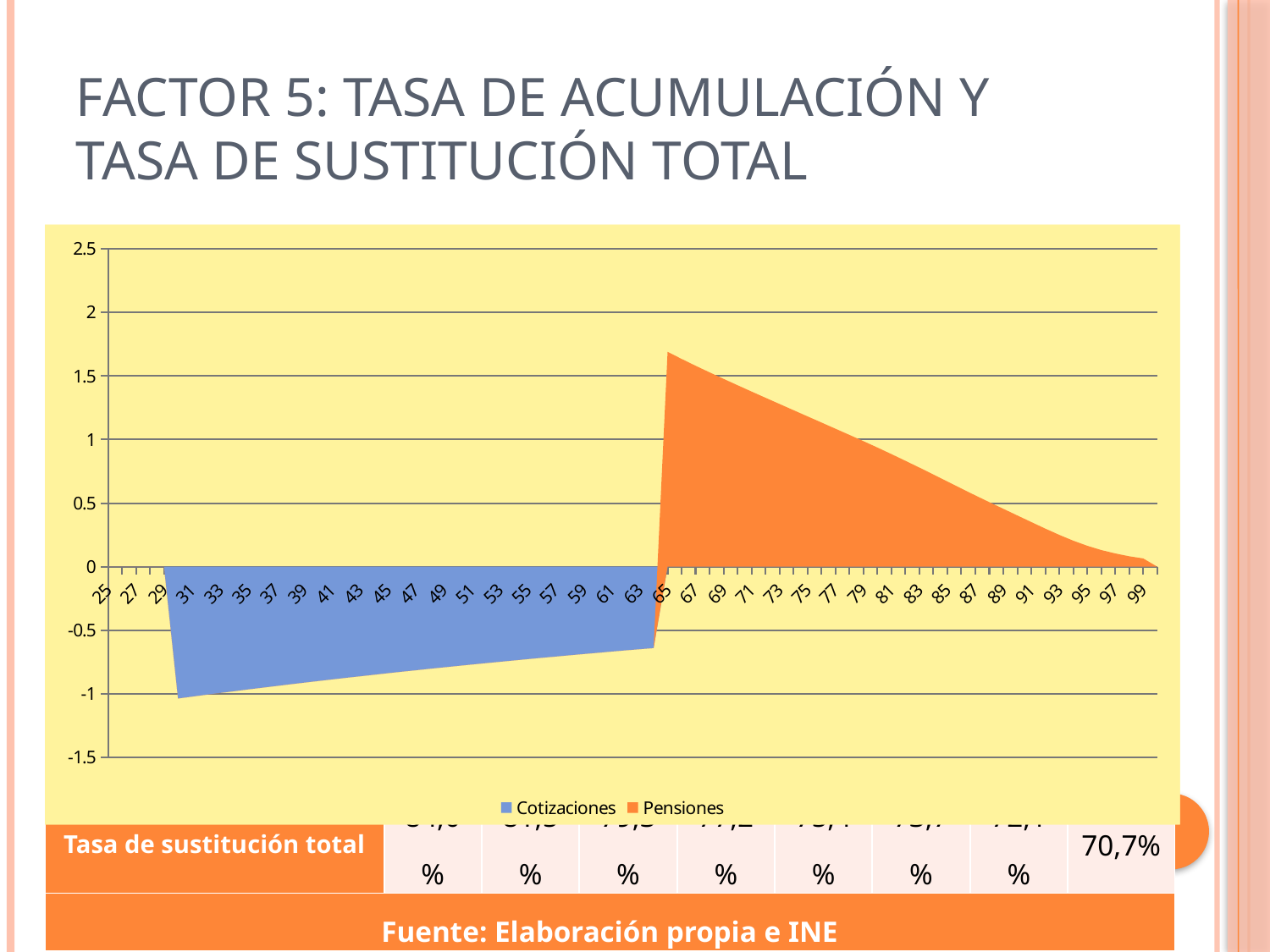
Is the value of Cotizaciones at age 63 greater or less than -1? greater Which series has positive values in the chart, Cotizaciones or Pensiones? Pensiones Is the value of Pensiones at age 65 greater or less than 1.5? greater Do the Cotizaciones values rise or fall as age increases from 31 to 63? Rise Is the value of Pensiones at age 71 greater or less than 1? greater How many series does the chart legend list? 2 Which colour represents the Pensiones series in the chart? Orange What are the two series named in the chart legend? Cotizaciones and Pensiones What kind of chart is shown on the slide? Area chart Do the Pensiones values rise or fall as age increases from 65 to 99? Fall